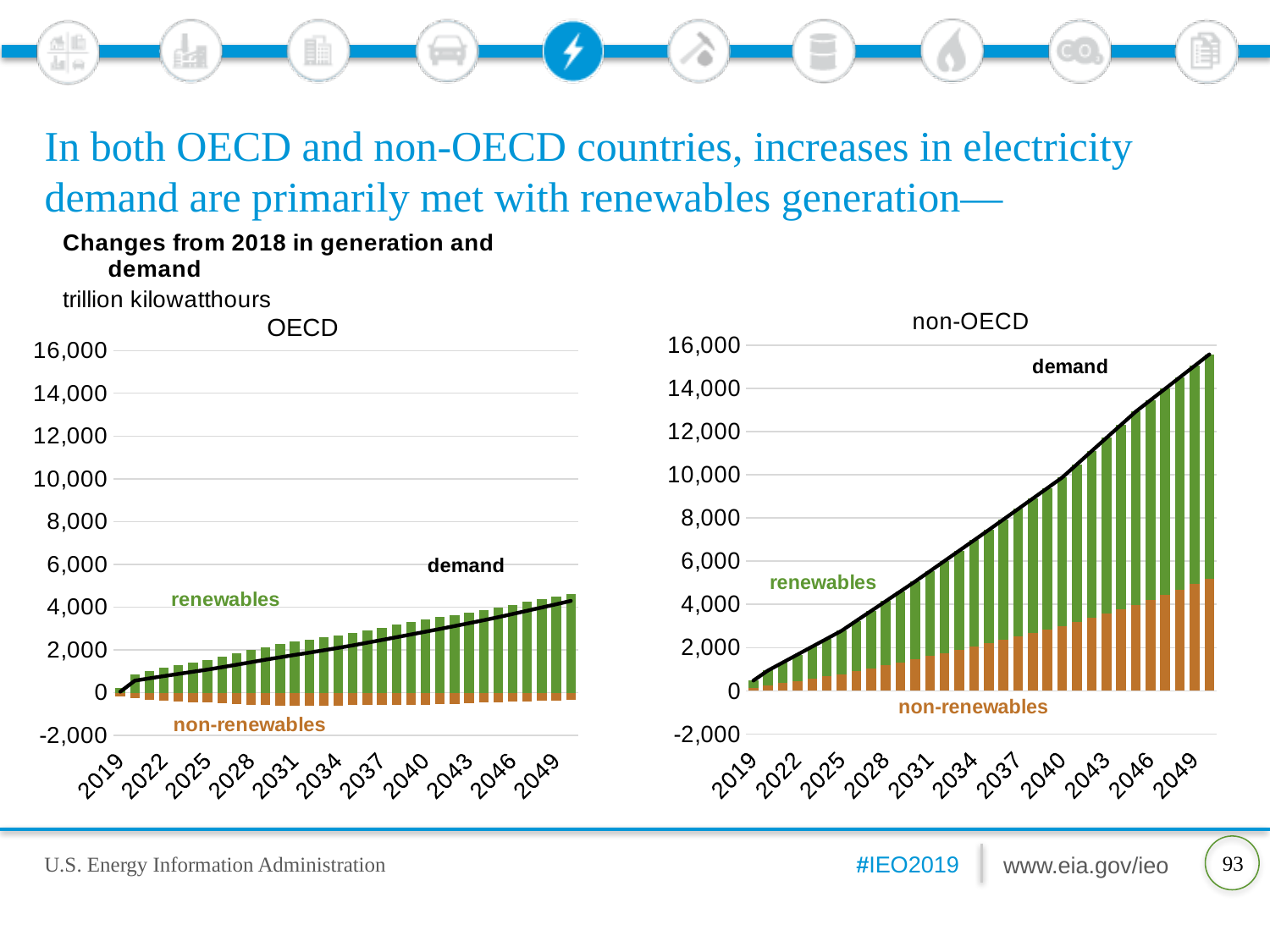
On the OECD chart, is the non-renewables value in 2049 greater or less than 0? less Which chart shows the larger demand value in 2049, OECD or non-OECD? non-OECD On the non-OECD chart, does the demand line rise or fall from 2019 to 2049? rises On the non-OECD chart, is the demand value in 2049 greater or less than 14,000? greater How many year labels are shown on the x axis of the OECD chart? 11 How many series are labelled on the non-OECD chart? 3 What kind of chart is the OECD chart? stacked bar chart with a line On the OECD chart, does the demand line rise or fall from 2019 to 2049? rises What unit is given for the values on the charts? trillion kilowatthours On the OECD chart, is the demand value in 2049 greater or less than 6,000? less